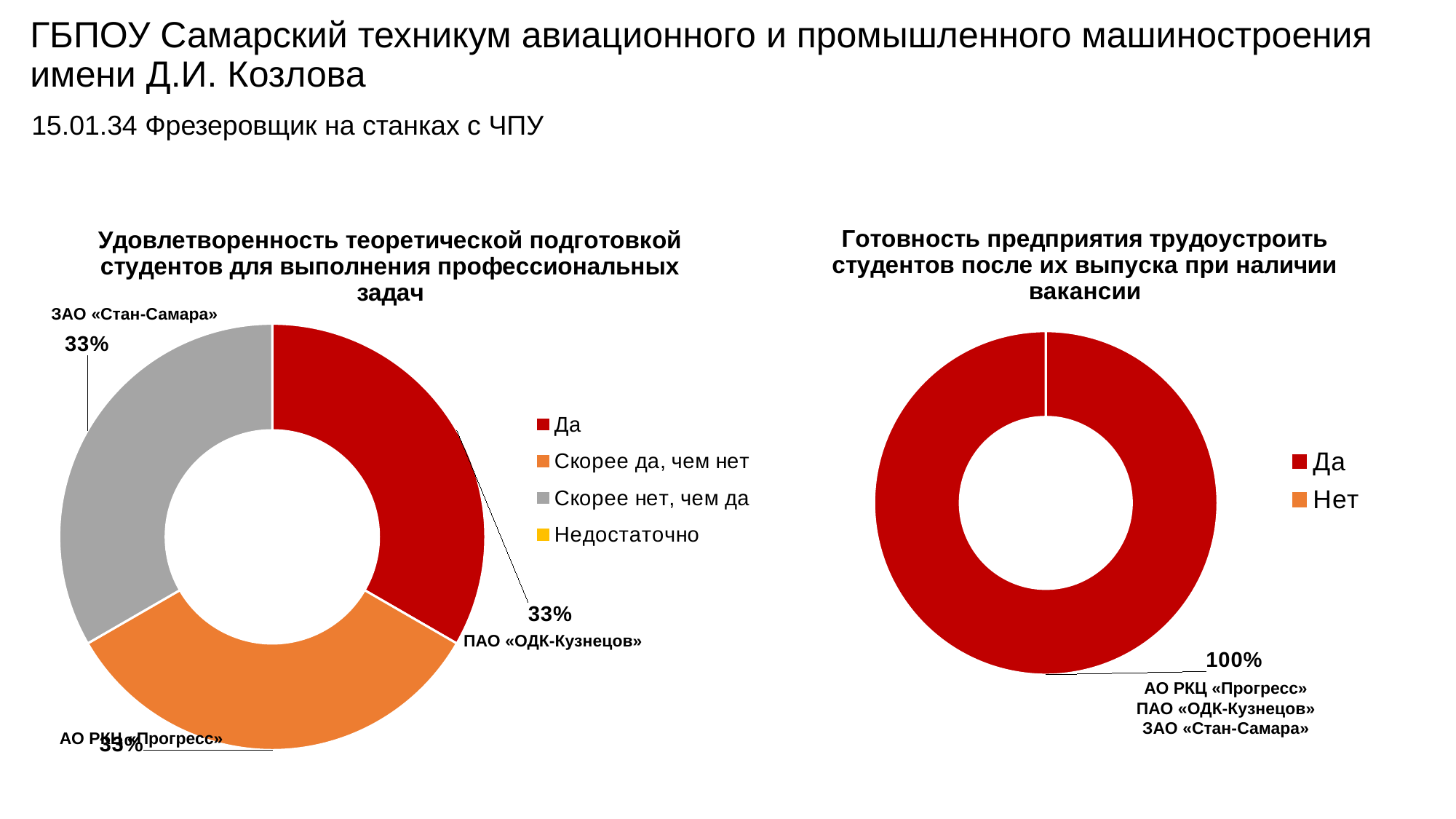
How many slices are visibly plotted in the left chart? 3 In the left chart, what share is labelled for the "Да" slice (ПАО «ОДК-Кузнецов»)? 33% In the right chart, which legend entry is shown in red? Да In the left chart, what share is labelled for the "Скорее да, чем нет" slice (АО РКЦ «Прогресс»)? 33% In the left chart, is the share for "Да" greater or less than 50%? less What kind of chart is the left chart, titled "Удовлетворенность теоретической подготовкой студентов для выполнения профессиональных задач"? Doughnut (pie) chart How many entries does the legend of the right chart list? 2 In the left chart, which enterprise is labelled next to the "Скорее нет, чем да" (grey) slice? ЗАО «Стан-Самара» In the left chart, what share is labelled for the "Скорее нет, чем да" slice (ЗАО «Стан-Самара»)? 33% In the right chart, what share is labelled for the "Да" slice? 100% How many entries does the legend of the left chart list? 4 What kind of chart is the right chart, titled "Готовность предприятия трудоустроить студентов после их выпуска при наличии вакансии"? Doughnut (pie) chart